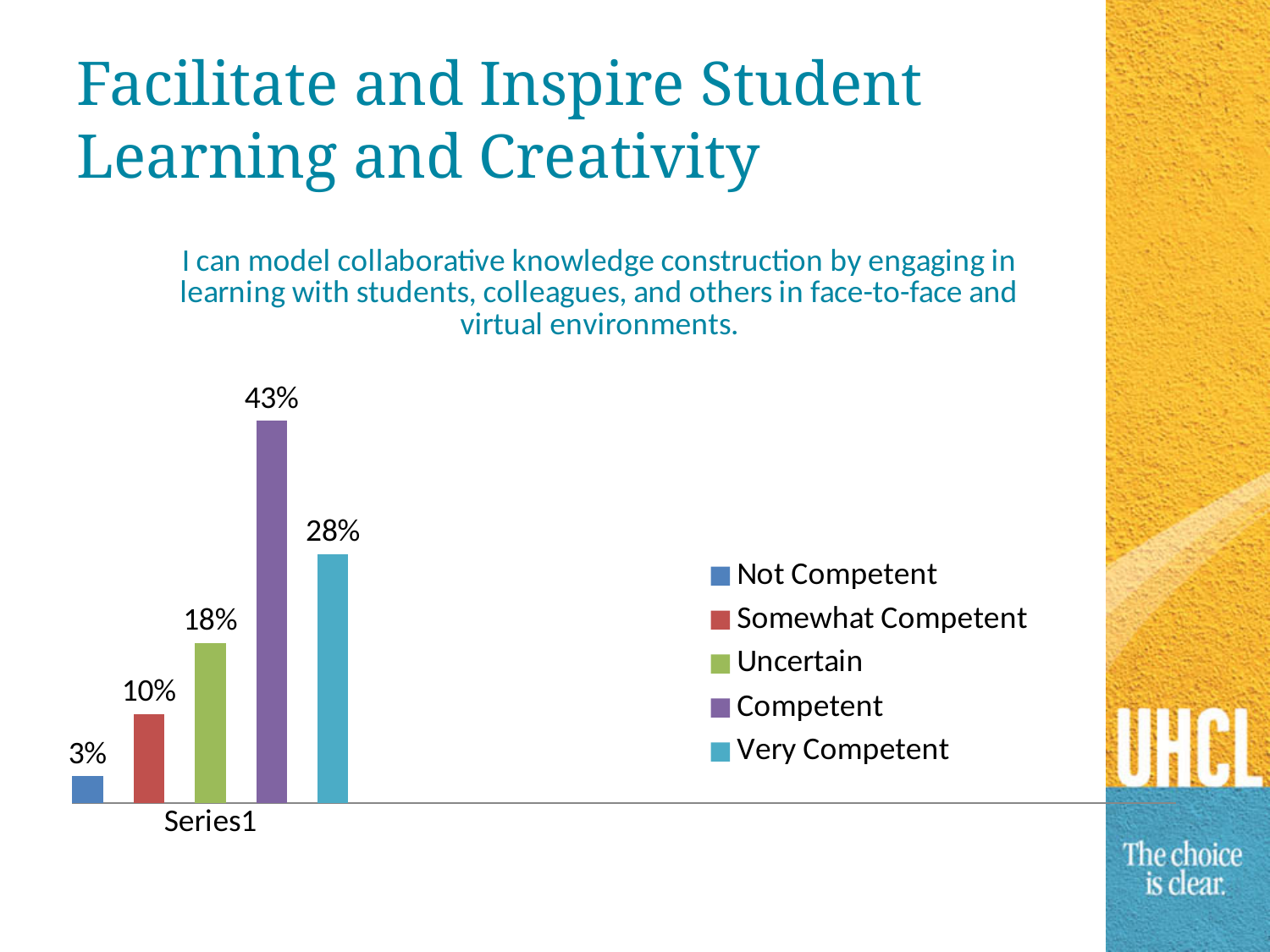
How many series does the legend list? 5 Which category has the lowest value? Not Competent Which category has the highest value? Competent What is the value for Not Competent? 3% Which is larger, the value for Somewhat Competent or the value for Uncertain? Uncertain What is the value for Very Competent? 28% What percentage of respondents rated themselves as Competent? 43% What is the value for Uncertain? 18% What is the difference between the Competent and Very Competent values? 15% What is the difference between the Uncertain and Somewhat Competent values? 8% What colour is the bar for Competent? Purple What kind of chart is shown on the slide? Bar chart